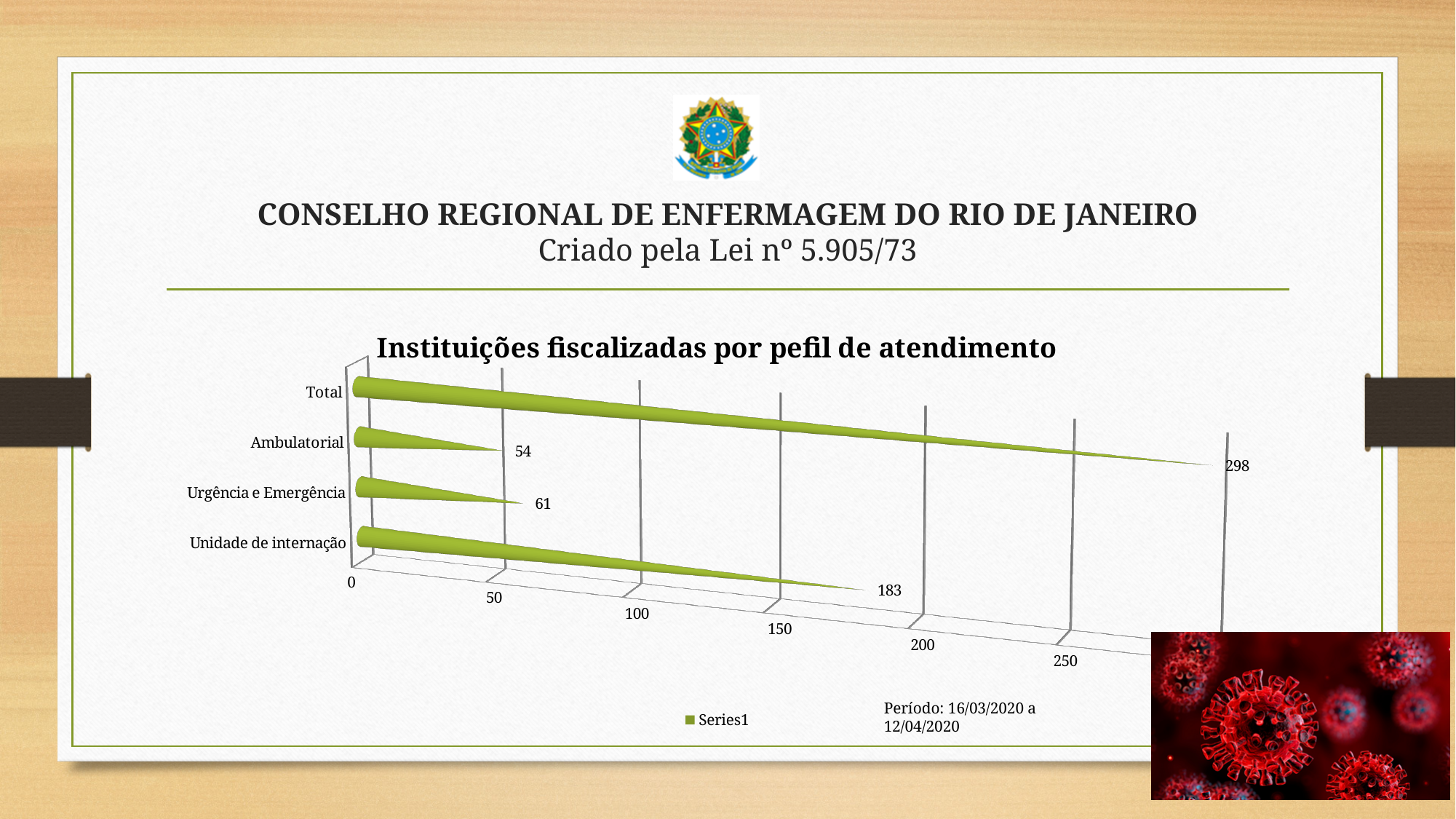
What kind of chart is shown on the slide? Bar chart How many categories are shown in the chart? 4 Which is larger, the value for Urgência e Emergência or the value for Ambulatorial? Urgência e Emergência What is the value for Ambulatorial? 54 Excluding Total, which category has the highest value? Unidade de internação What is the value for Unidade de internação? 183 What is the value for Urgência e Emergência? 61 Which category has the lowest value? Ambulatorial What is the title of the chart? Instituições fiscalizadas por pefil de atendimento What is the difference between the values for Unidade de internação and Urgência e Emergência? 122 What is the value for Total in the chart "Instituições fiscalizadas por pefil de atendimento"? 298 Is the value for Unidade de internação greater or less than 150? greater